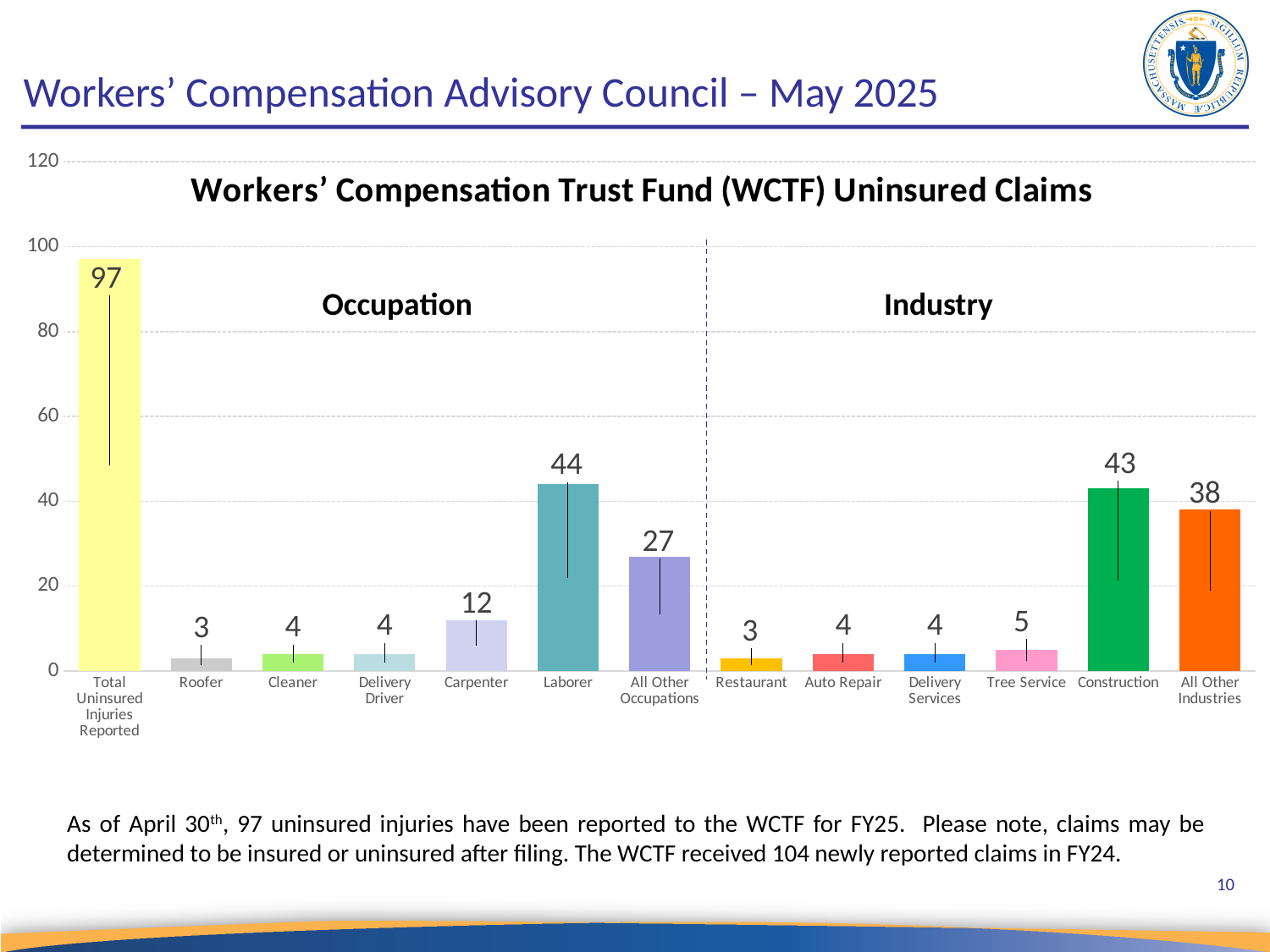
What is the value for Total Uninsured Injuries Reported? 97 What is the difference between the values for Laborer and All Other Occupations? 17 What is the title of the chart? Workers' Compensation Trust Fund (WCTF) Uninsured Claims What kind of chart is this? Bar chart What is the value for Laborer? 44 What is the value for Construction? 43 Which category has the lowest value? Roofer and Restaurant (both 3) Excluding the Total Uninsured Injuries Reported bar, which category has the highest value? Laborer Is the value for Total Uninsured Injuries Reported greater or less than 80? greater Which is larger, the value for Construction or the value for All Other Industries? Construction How many categories are shown on the x axis? 13 What is the value for Carpenter? 12